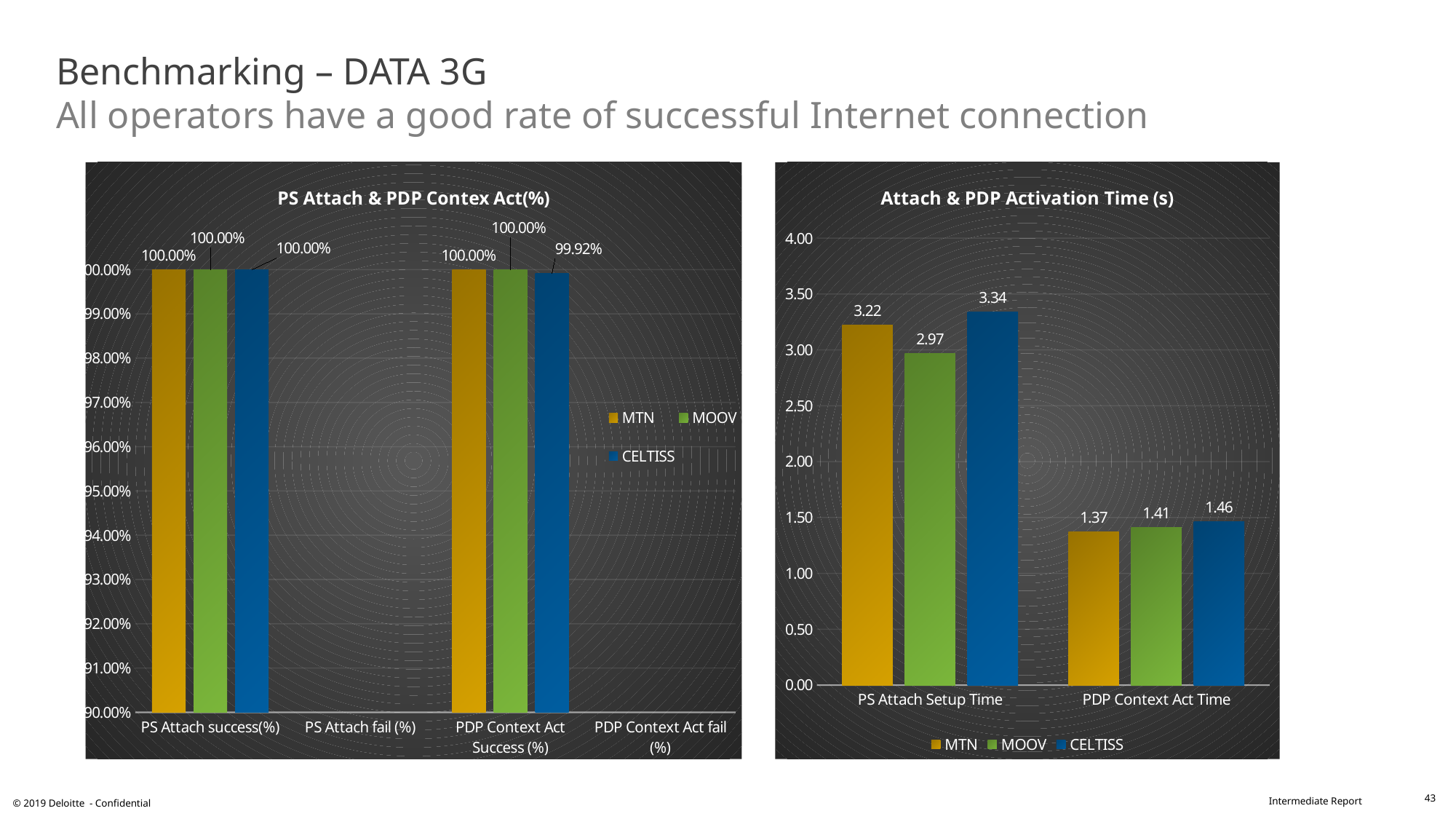
How many series does the legend of the 'Attach & PDP Activation Time (s)' chart list? 3 In the 'PS Attach & PDP Contex Act(%)' chart, what is the PS Attach success(%) value for MOOV? 100.00% In the 'PS Attach & PDP Contex Act(%)' chart, how many categories are shown on the x axis? 4 In the 'Attach & PDP Activation Time (s)' chart, which operator has the lowest PS Attach Setup Time? MOOV In the 'Attach & PDP Activation Time (s)' chart, what is the difference between the PS Attach Setup Time of CELTISS and MOOV? 0.37 In the 'PS Attach & PDP Contex Act(%)' chart, what is the PDP Context Act Success (%) value for CELTISS? 99.92% In the 'Attach & PDP Activation Time (s)' chart, what is the PS Attach Setup Time for MTN? 3.22 In the 'Attach & PDP Activation Time (s)' chart, which is larger: the PDP Context Act Time for MOOV or for MTN? MOOV What type of chart is the 'Attach & PDP Activation Time (s)' chart? Bar chart In the 'Attach & PDP Activation Time (s)' chart, is the PDP Context Act Time for MTN greater or less than 1.50? less In the 'Attach & PDP Activation Time (s)' chart, which operator has the highest PS Attach Setup Time? CELTISS In the 'Attach & PDP Activation Time (s)' chart, what is the PDP Context Act Time for CELTISS? 1.46